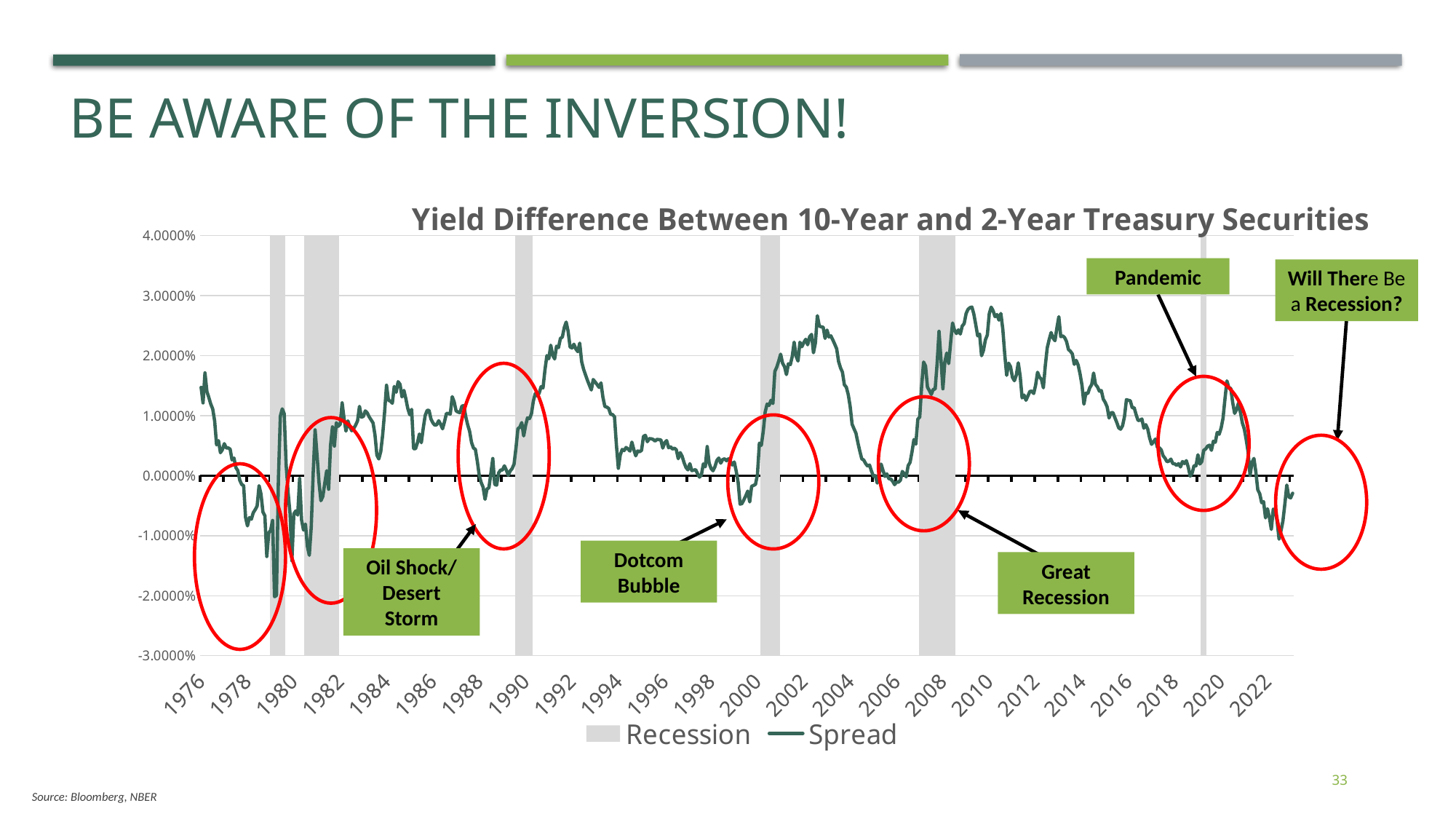
How many shaded recession bands are shown on the chart? 6 Does the Spread generally rise or fall between 2010 and 2019? fall Is the peak value of the Spread around 1992 greater or less than 2.0000%? greater What is the title of the chart? Yield Difference Between 10-Year and 2-Year Treasury Securities Is the value of the Spread at the end of the series in 2022-2023 greater or less than 0.0000%? less What kind of chart is shown on the slide? Line chart What are the two entries in the chart legend? Recession and Spread Is the peak value of the Spread around 2010 greater or less than 2.0000%? greater How many entries does the chart legend list? 2 What is the highest value shown on the vertical axis? 4.0000% Does the Spread generally rise or fall between 2000 and 2003? rise